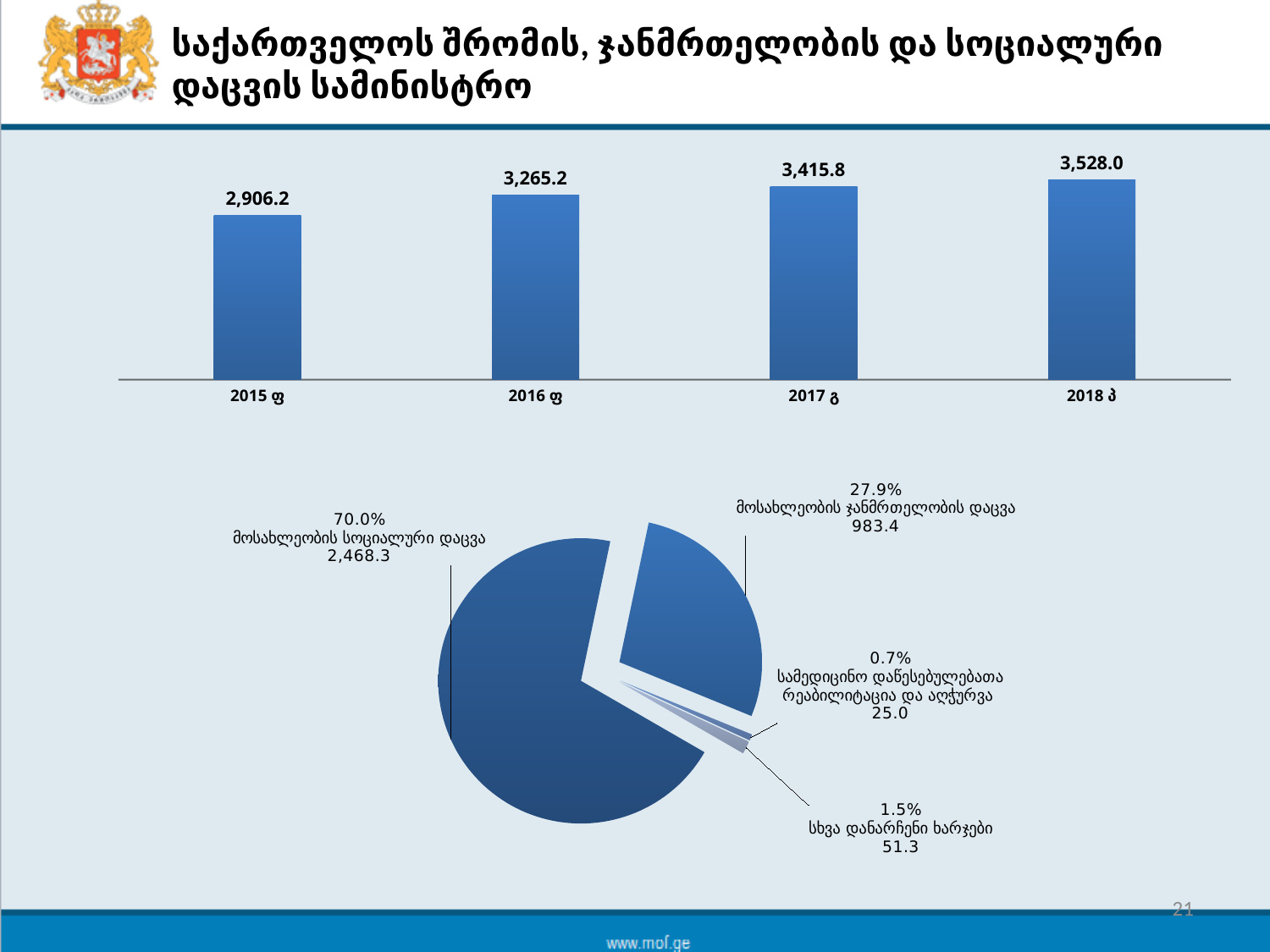
In the bottom pie chart, what share does მოსახლეობის სოციალური დაცვა have? 70.0% In the bottom pie chart, which slice is the smallest? სამედიცინო დაწესებულებათა რეაბილიტაცია და აღჭურვა In the top bar chart, which year has the highest value? 2018 პ In the bottom pie chart, what is the value for მოსახლეობის ჯანმრთელობის დაცვა? 983.4 In the top bar chart, which year has the lowest value? 2015 ფ In the top bar chart, do the values rise or fall from 2015 ფ to 2018 პ? rise How many slices does the bottom pie chart have? 4 In the top bar chart, what is the value for 2015 ფ? 2,906.2 What kind of chart is shown at the top of the slide? bar chart In the top bar chart, what is the value for 2018 პ? 3,528.0 In the top bar chart, what is the difference between the values for 2016 ფ and 2015 ფ? 359.0 How many bars are in the top bar chart? 4